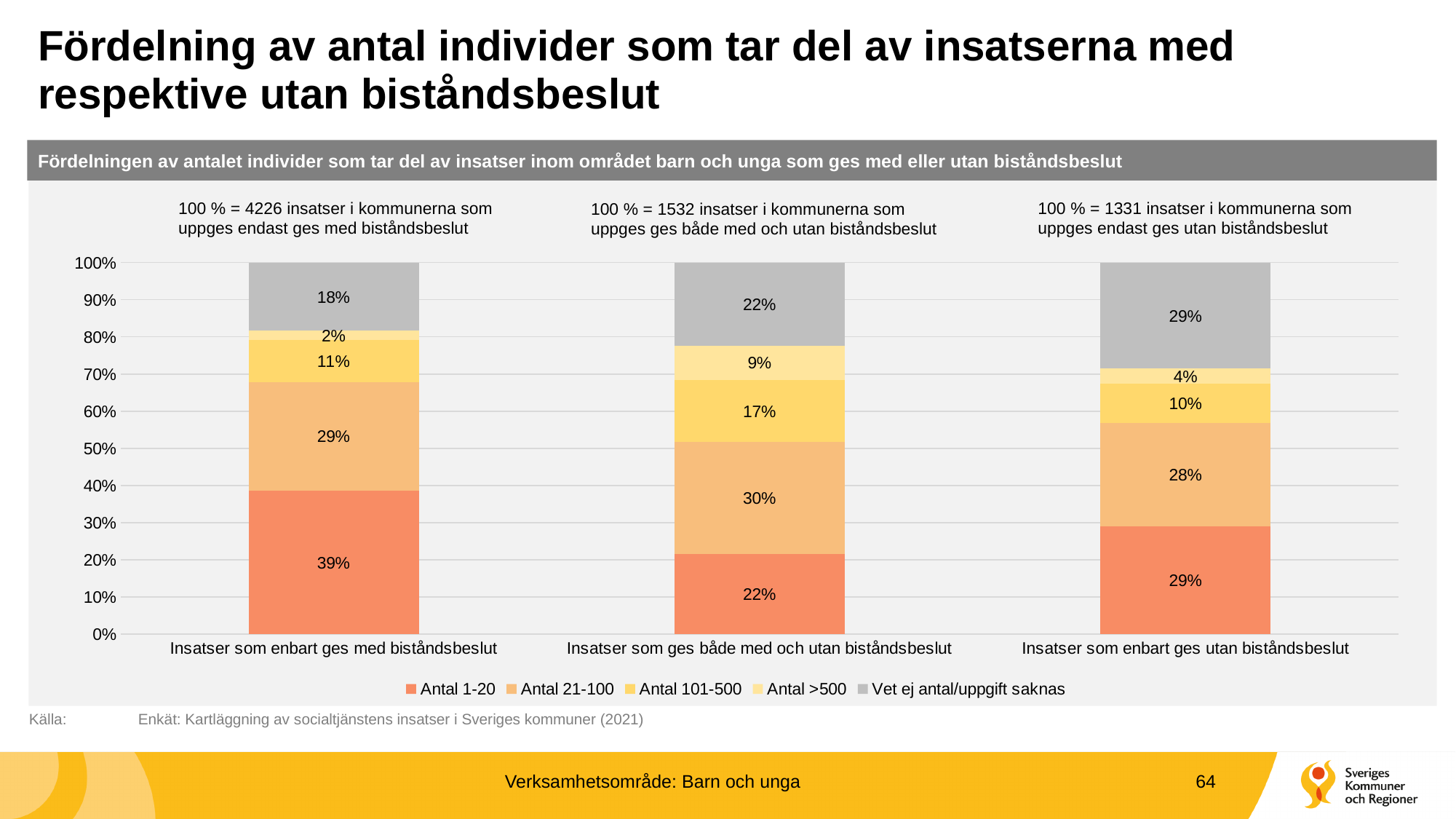
What is the value for Antal >500 in the category 'Insatser som enbart ges med biståndsbeslut'? 2% What is the difference between the Antal 101-500 values for 'Insatser som ges både med och utan biståndsbeslut' and 'Insatser som enbart ges utan biståndsbeslut'? 7% Which is larger: the Vet ej antal/uppgift saknas value for 'Insatser som enbart ges med biståndsbeslut' or for 'Insatser som ges både med och utan biståndsbeslut'? Insatser som ges både med och utan biståndsbeslut Which category has the highest value for Antal 1-20? Insatser som enbart ges med biståndsbeslut Which category has the lowest value for Antal >500? Insatser som enbart ges med biståndsbeslut What is the value for Antal 1-20 in the category 'Insatser som enbart ges med biståndsbeslut'? 39% What kind of chart is shown on the slide? stacked bar chart How many series does the legend list? 5 How many categories are shown on the x axis? 3 According to the note above the first bar, how many insatser does 100 % correspond to for 'Insatser som enbart ges med biståndsbeslut'? 4226 What is the value for Antal 21-100 in the category 'Insatser som ges både med och utan biståndsbeslut'? 30% What is the value for Vet ej antal/uppgift saknas in the category 'Insatser som enbart ges utan biståndsbeslut'? 29%